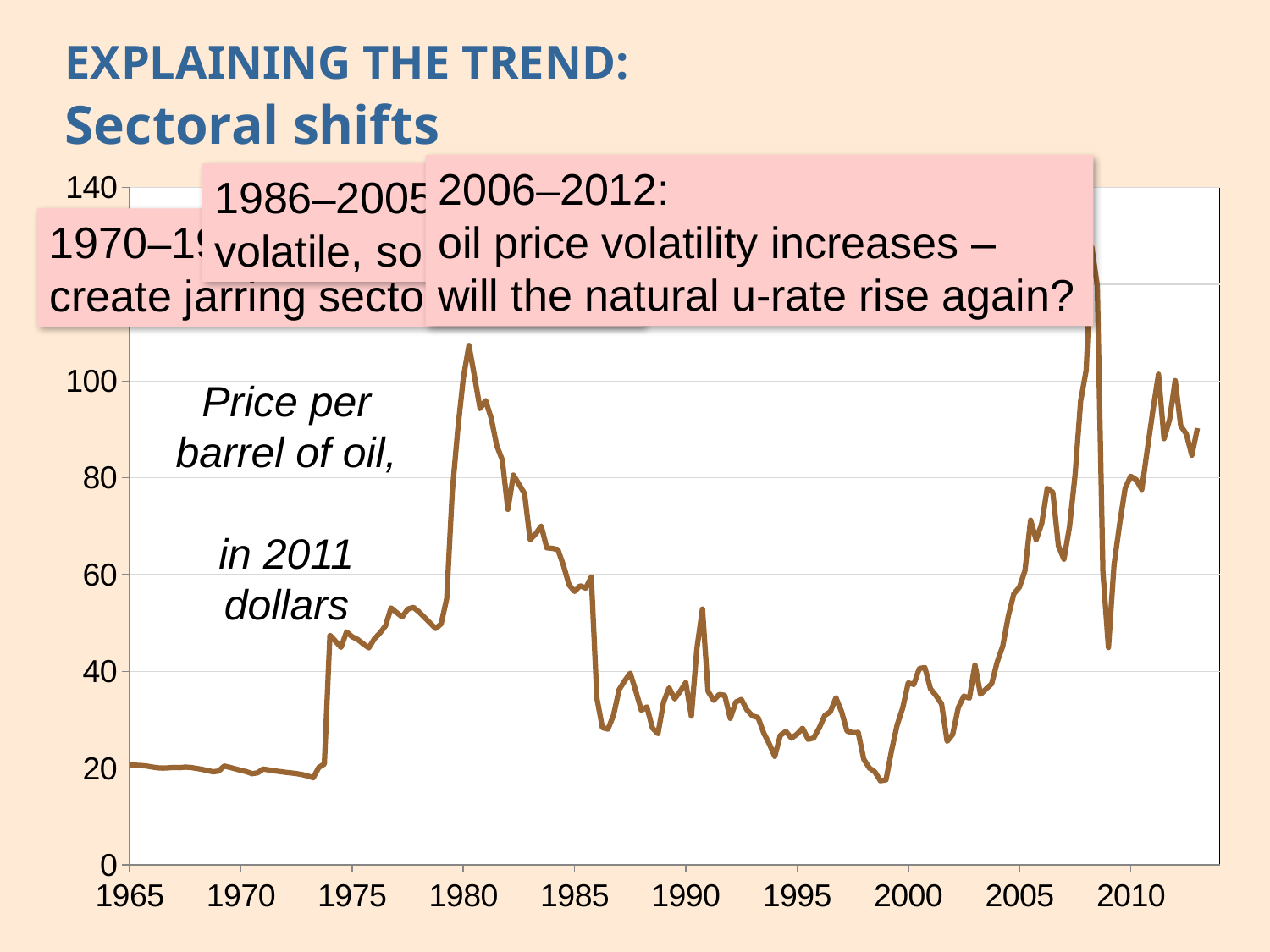
Is the oil price at its 1980 peak greater or less than 100? greater Which year has the higher oil price, 1965 or 2005? 2005 Is the oil price in 1995 greater or less than 40? less Is the oil price in 2005 greater or less than 40? greater Does the oil price rise or fall between 1999 and 2008? rise What is the highest value shown on the vertical axis? 140 Does the oil price rise or fall between 1980 and 1986? fall Which year has the higher oil price, 1980 or 1995? 1980 According to the label inside the chart, what does the line plot? Price per barrel of oil, in 2011 dollars What kind of chart is shown on the slide? line chart